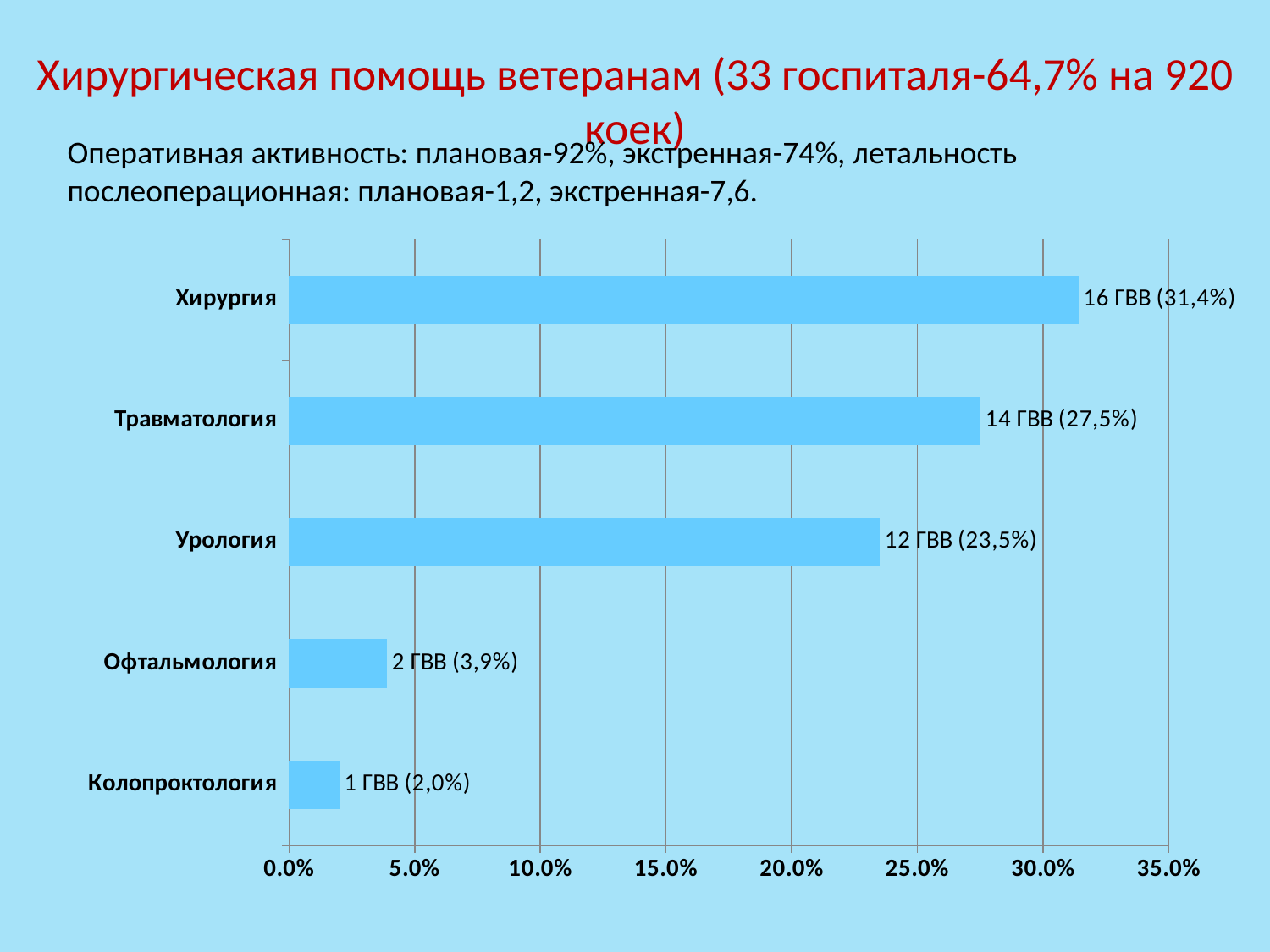
What type of chart is shown on the slide? bar chart What percentage is shown for Травматология? 27,5% Is the value for Офтальмология greater or less than 5.0%? less How many ГВВ are shown for Урология? 12 ГВВ Which category has the highest value? Хирургия Which category has the lowest value? Колопроктология How many categories are shown in the chart? 5 Which is larger, the value for Травматология or the value for Урология? Травматология What is the difference in ГВВ between Хирургия and Травматология? 2 ГВВ What is the data label for Колопроктология? 1 ГВВ (2,0%) What is the data label shown for Хирургия? 16 ГВВ (31,4%) What is the difference in percentage points between Урология and Офтальмология? 19,6